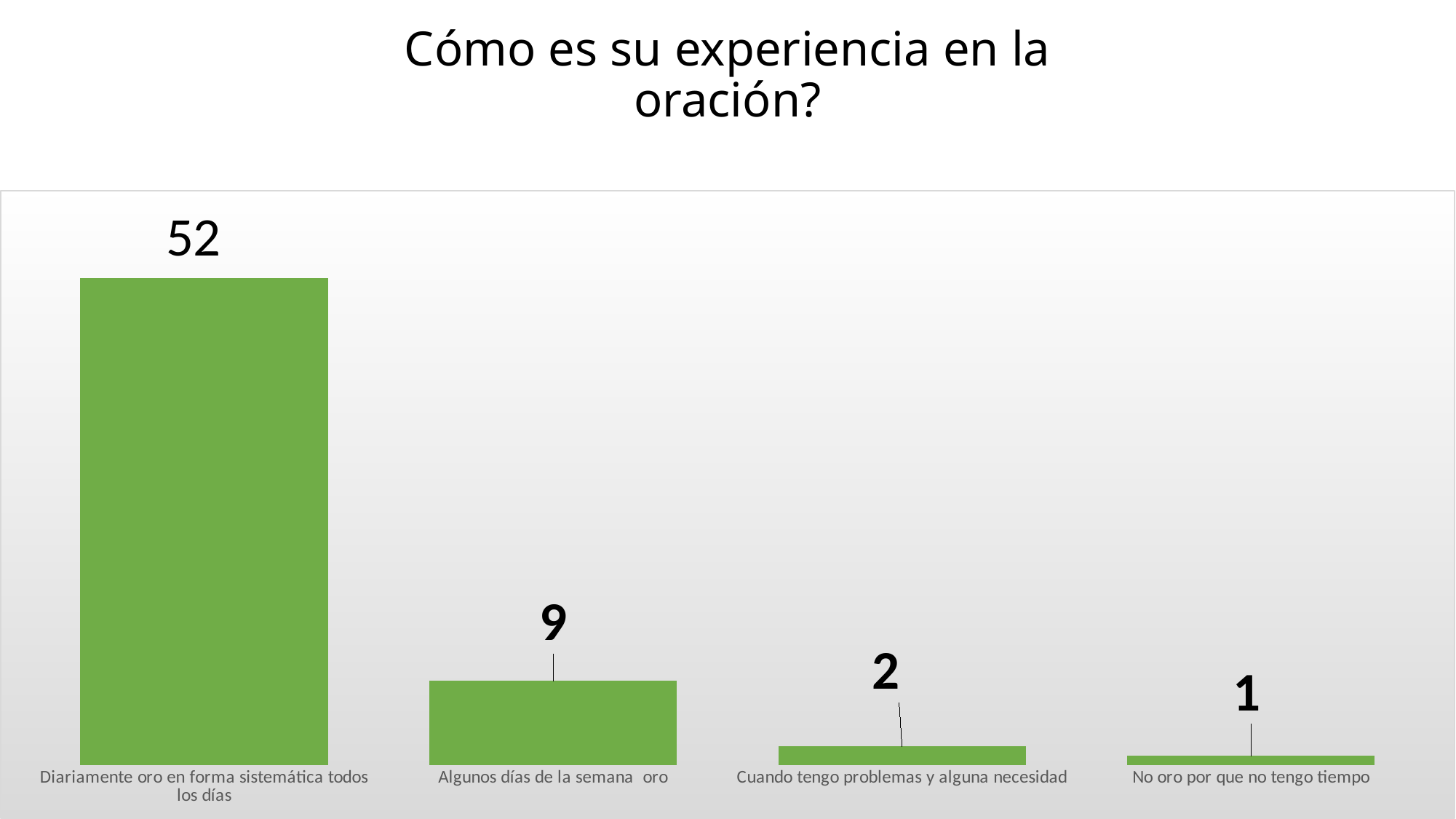
What is the title of the slide? Cómo es su experiencia en la oración? What is the value for "Cuando tengo problemas y alguna necesidad"? 2 What is the difference between the values for "Diariamente oro en forma sistemática todos los días" and "Algunos días de la semana oro"? 43 What is the value for "No oro por que no tengo tiempo"? 1 What is the difference between the values for "Cuando tengo problemas y alguna necesidad" and "No oro por que no tengo tiempo"? 1 Which category has the highest value? Diariamente oro en forma sistemática todos los días What is the value for "Algunos días de la semana oro"? 9 Which is larger, the value for "Algunos días de la semana oro" or the value for "Cuando tengo problemas y alguna necesidad"? Algunos días de la semana oro How many categories are shown in the chart? 4 Which category has the lowest value? No oro por que no tengo tiempo What is the value for "Diariamente oro en forma sistemática todos los días"? 52 What kind of chart is shown on the slide? Bar chart